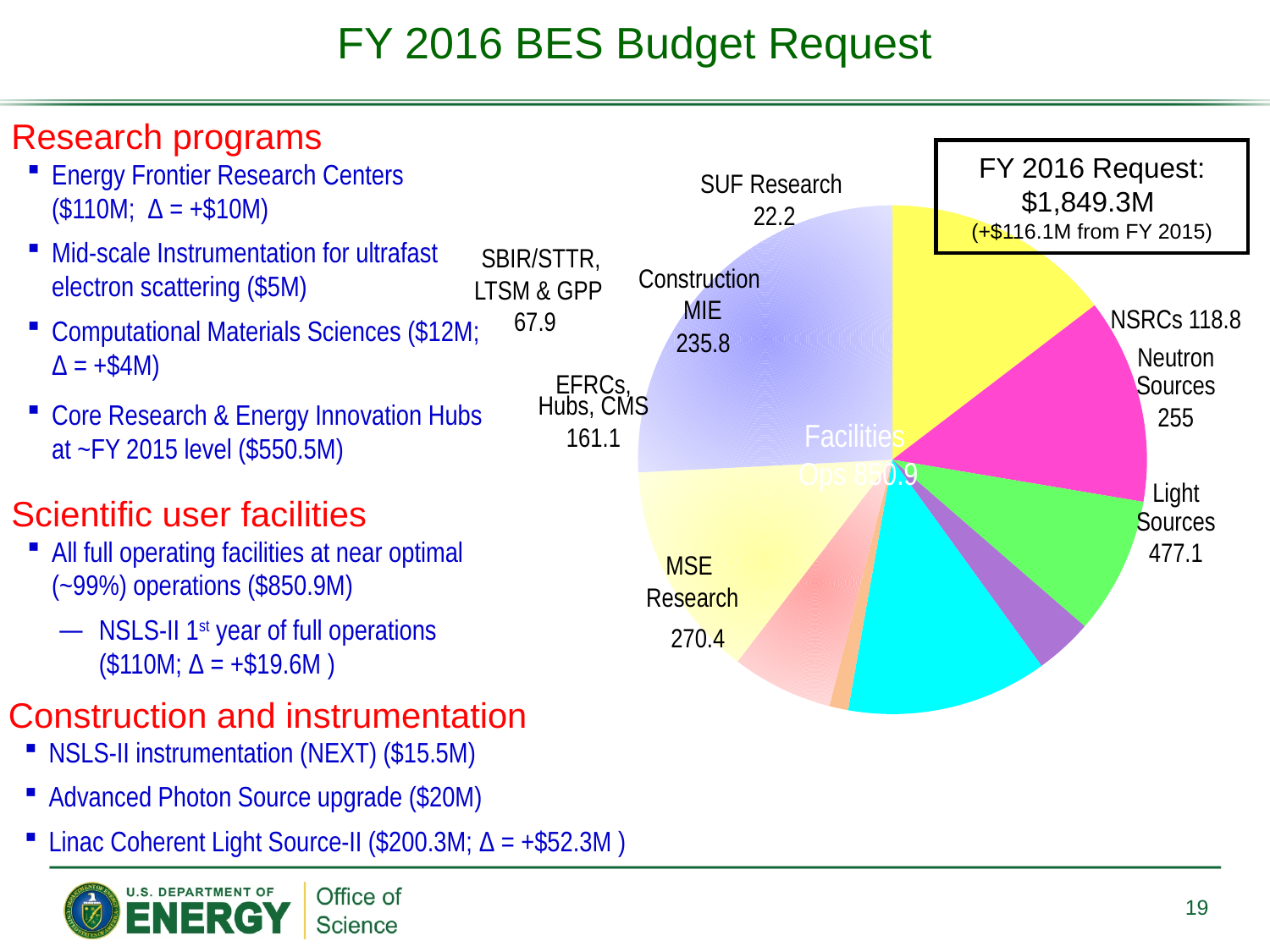
What type of chart is shown on the slide? pie chart What is the value shown for Light Sources in the pie chart? 477.1 What total FY 2016 request amount is shown in the box next to the pie chart? $1,849.3M What is the value shown for Construction MIE in the pie chart? 235.8 What is the value shown for NSRCs in the pie chart? 118.8 Which is larger in the pie chart, MSE Research or Construction MIE? MSE Research What is the value shown for MSE Research in the pie chart? 270.4 Of the labeled slices in the pie chart, which has the smallest value? SUF Research What is the title of the slide containing the pie chart? FY 2016 BES Budget Request What is the value shown for SBIR/STTR, LTSM & GPP in the pie chart? 67.9 What is the difference between the Light Sources value and the Neutron Sources value in the pie chart? 222.1 Which labeled slice of the pie chart has the largest value? Light Sources